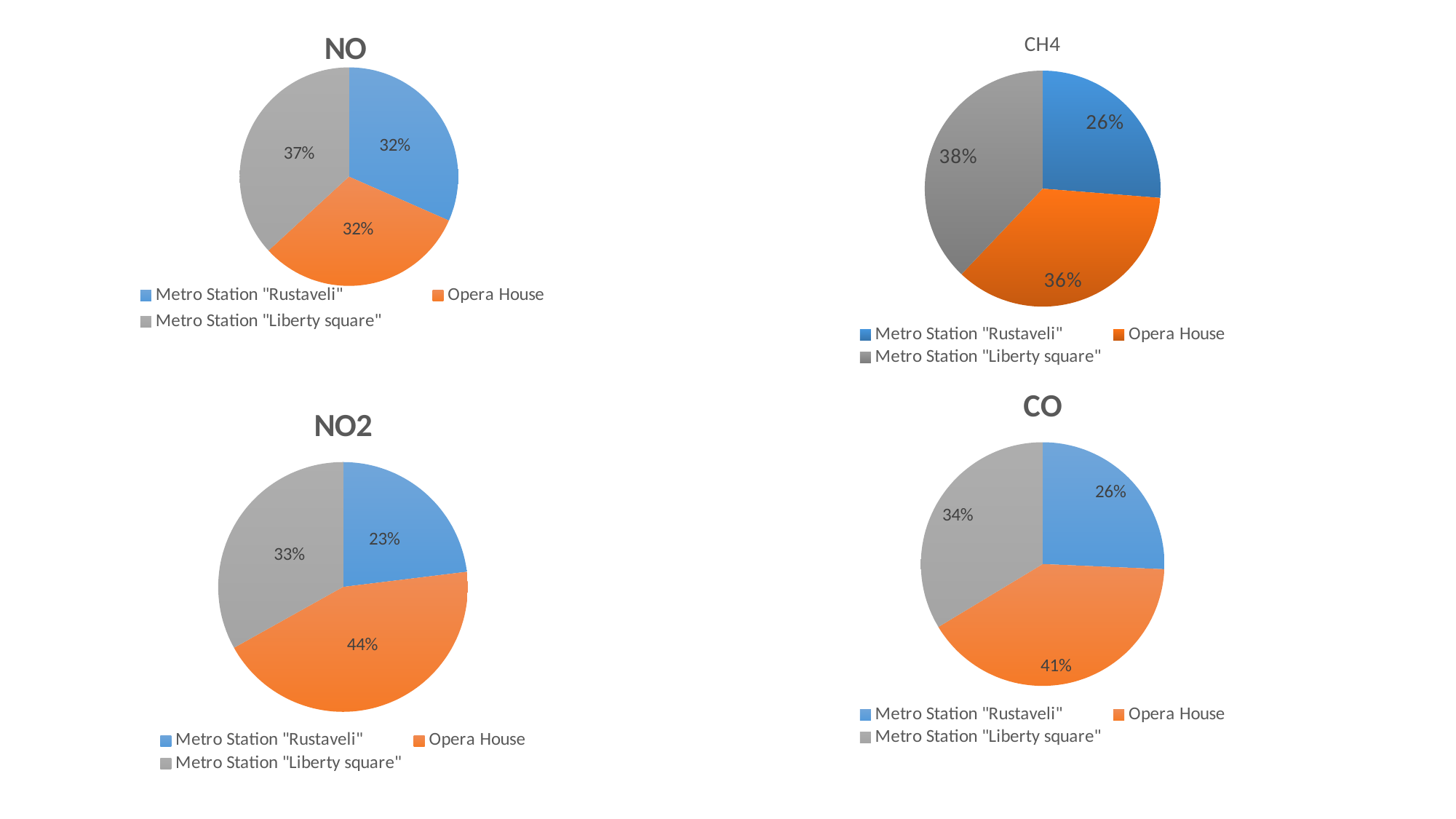
In the CH4 chart, what share does Opera House have? 36% In the NO2 chart, what share does Metro Station "Rustaveli" have? 23% How many charts are on the slide? 4 In the CO chart, which category has the largest slice? Opera House In the NO2 chart, what is the difference between the Opera House share and the Metro Station "Rustaveli" share? 21% In the NO chart, what share does Metro Station "Liberty square" have? 37% In the CO chart, which is larger: Metro Station "Liberty square" or Metro Station "Rustaveli"? Metro Station "Liberty square" What kind of chart is the CH4 chart? Pie chart In the NO2 chart, which category has the largest slice? Opera House In the CO chart, what share does Opera House have? 41% How many categories does the NO chart show? 3 In the CH4 chart, which category has the smallest slice? Metro Station "Rustaveli"